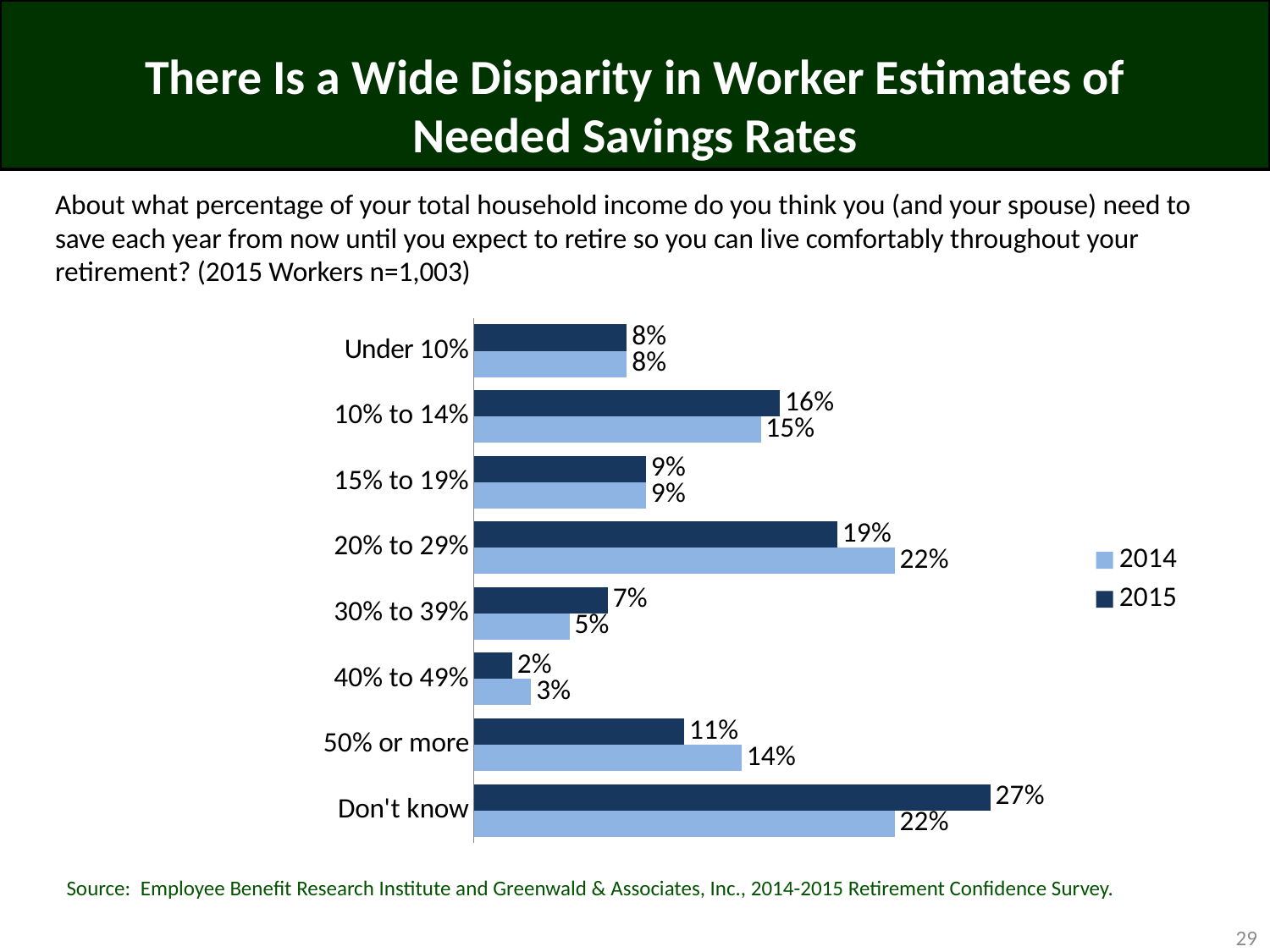
For "30% to 39%", which year has the larger value, 2014 or 2015? 2015 What is the difference between the 2015 and 2014 values for "Don't know"? 5% Which category has the lowest 2014 value? 40% to 49% How many series does the legend list? 2 Which category has the highest 2015 value? Don't know What is the difference between the 2014 and 2015 values for "50% or more"? 3% For "20% to 29%", which year has the larger value, 2014 or 2015? 2014 How many categories are shown on the chart? 8 What kind of chart is shown on the slide? Bar chart What is the 2014 value for "20% to 29%"? 22% What is the 2015 value for "50% or more"? 11% What is the 2015 value for "Don't know"? 27%